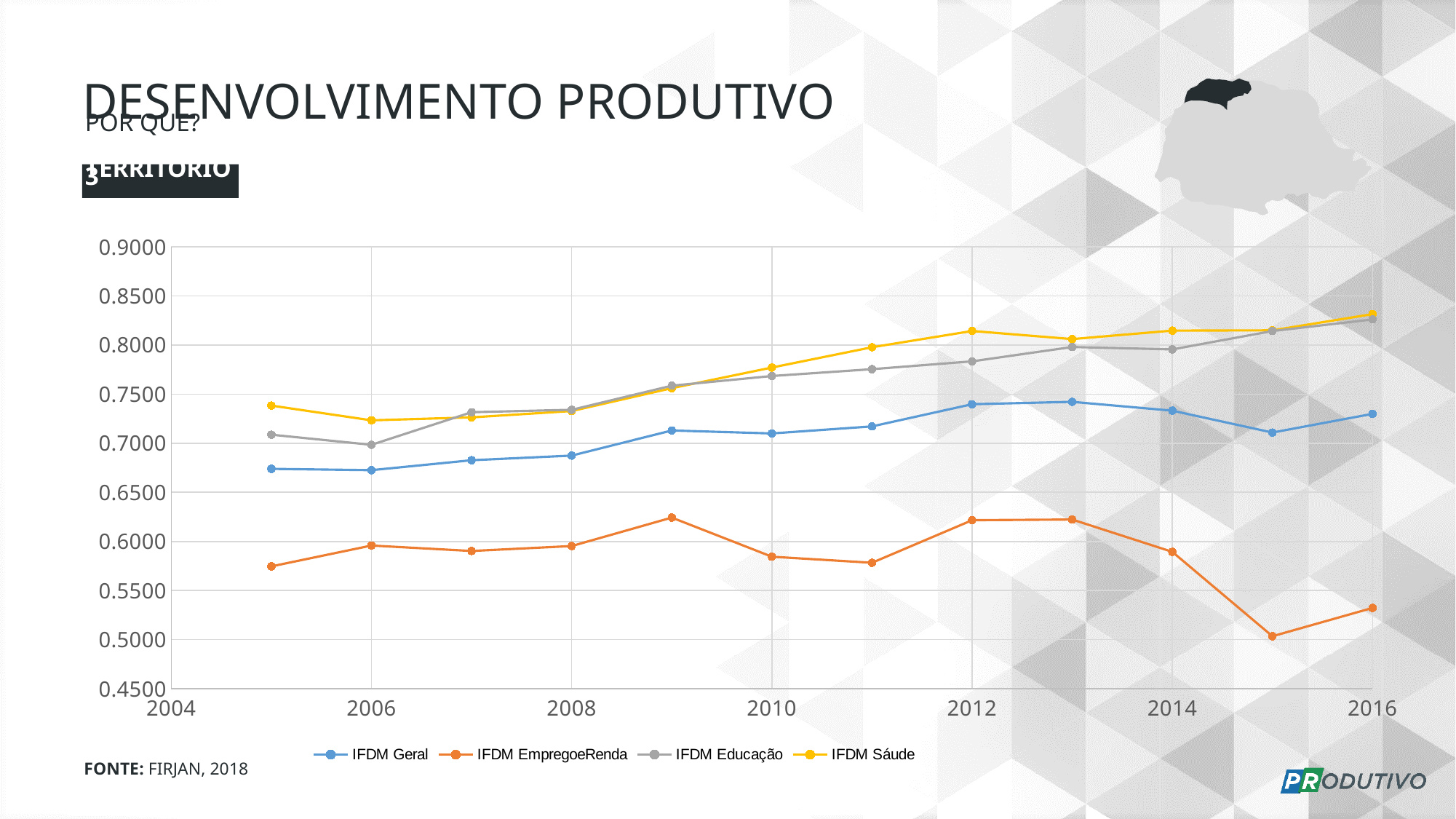
In 2016, which is larger: IFDM Geral or IFDM EmpregoeRenda? IFDM Geral Does the IFDM Educação line generally rise or fall from 2005 to 2016? rise In which year does IFDM EmpregoeRenda reach its lowest value? 2015 Is the value for IFDM Educação in 2005 greater or less than 0.7500? less Is the value for IFDM EmpregoeRenda in 2015 greater or less than 0.5500? less Is the value for IFDM Geral in 2005 greater or less than 0.7000? less Which series has the highest value in 2012? IFDM Sáude How many data points does each line in the chart have? 12 How many series does the chart's legend list? 4 What kind of chart is shown on the slide? line chart Which series has the lowest value in 2016? IFDM EmpregoeRenda